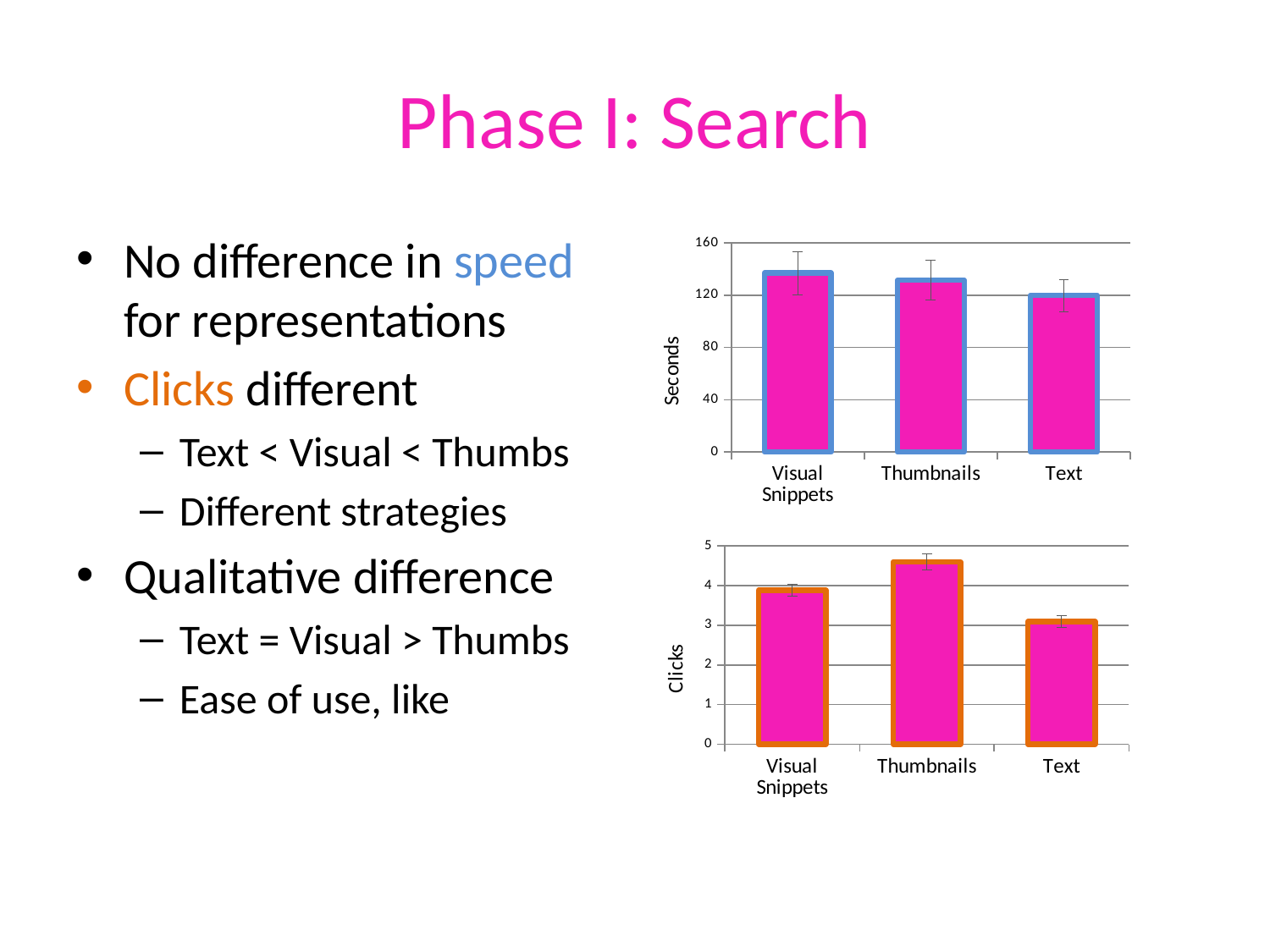
What kind of chart is the top chart (Seconds)? bar chart In the top chart (Seconds), is the value for Text greater or less than 160? less How many categories are shown on the x axis of the bottom chart (Clicks)? 3 In the top chart (Seconds), is the value for Visual Snippets greater or less than 120? greater In the bottom chart (Clicks), is the value for Thumbnails greater or less than 4? greater What kind of chart is the bottom chart (Clicks)? bar chart In the bottom chart (Clicks), which is larger, the value for Thumbnails or the value for Text? Thumbnails In the bottom chart (Clicks), which category has the lowest value? Text In the top chart (Seconds), which category has the lowest value? Text In the bottom chart (Clicks), which category has the highest value? Thumbnails What is the y-axis label of the top chart? Seconds